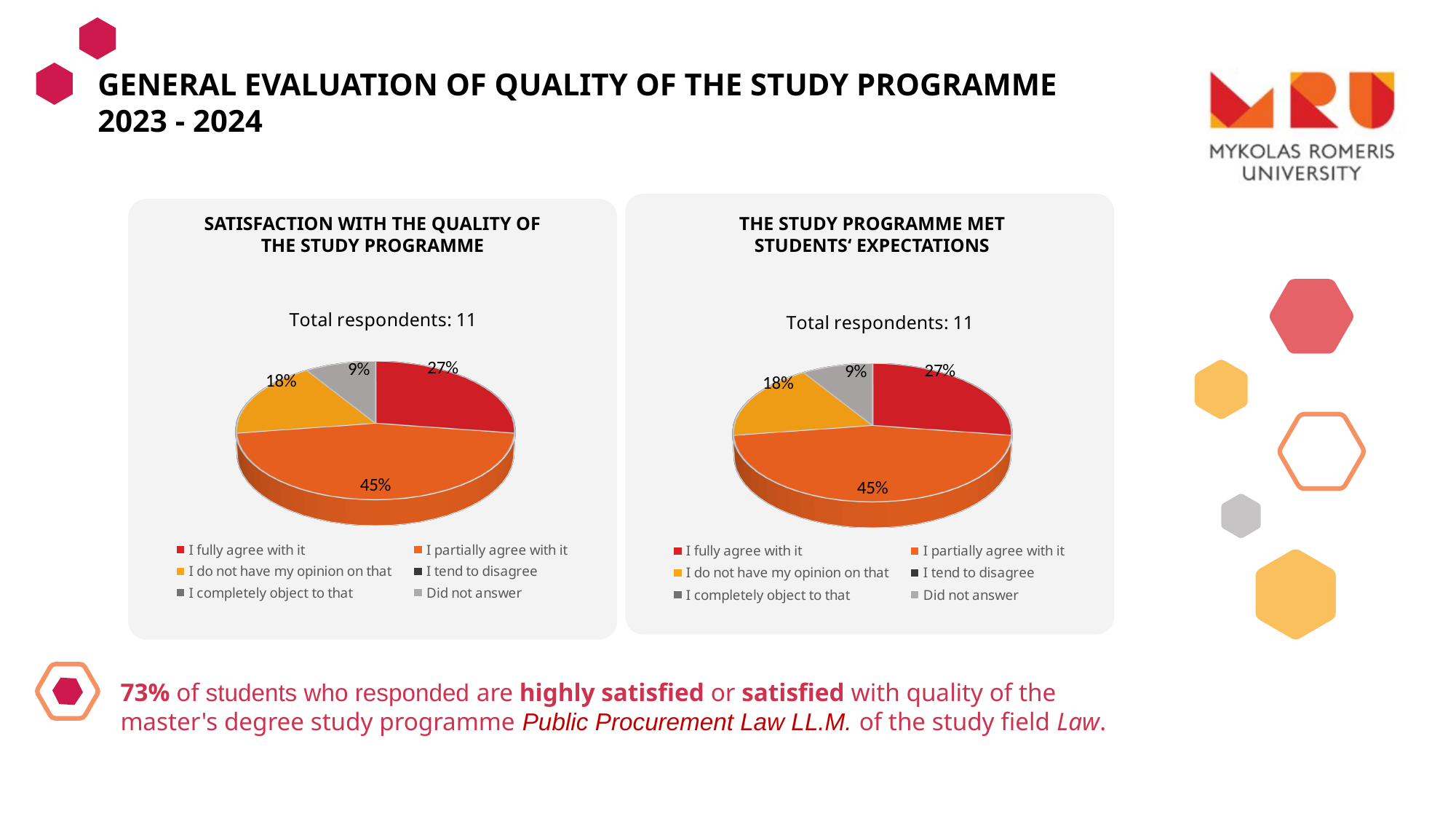
In the 'The study programme met students' expectations' chart, what share of respondents chose 'I do not have my opinion on that'? 18% How many slices are shown in the 'Satisfaction with the quality of the study programme' pie chart? 4 In the 'The study programme met students' expectations' chart, what share of respondents did not answer? 9% How many entries does the legend of the 'The study programme met students' expectations' chart list? 6 In the 'Satisfaction with the quality of the study programme' chart, what is the difference between the shares for 'I partially agree with it' and 'I fully agree with it'? 18% What type of chart is used in 'Satisfaction with the quality of the study programme'? Pie chart In the 'Satisfaction with the quality of the study programme' chart, what share of respondents chose 'I fully agree with it'? 27% In the 'Satisfaction with the quality of the study programme' chart, what share of respondents chose 'I partially agree with it'? 45% In the 'The study programme met students' expectations' chart, which response has the smallest share? Did not answer In the 'The study programme met students' expectations' chart, which is larger: the share for 'I fully agree with it' or 'I do not have my opinion on that'? I fully agree with it In the 'Satisfaction with the quality of the study programme' chart, which response has the largest share? I partially agree with it How many total respondents are reported for the 'The study programme met students' expectations' chart? 11